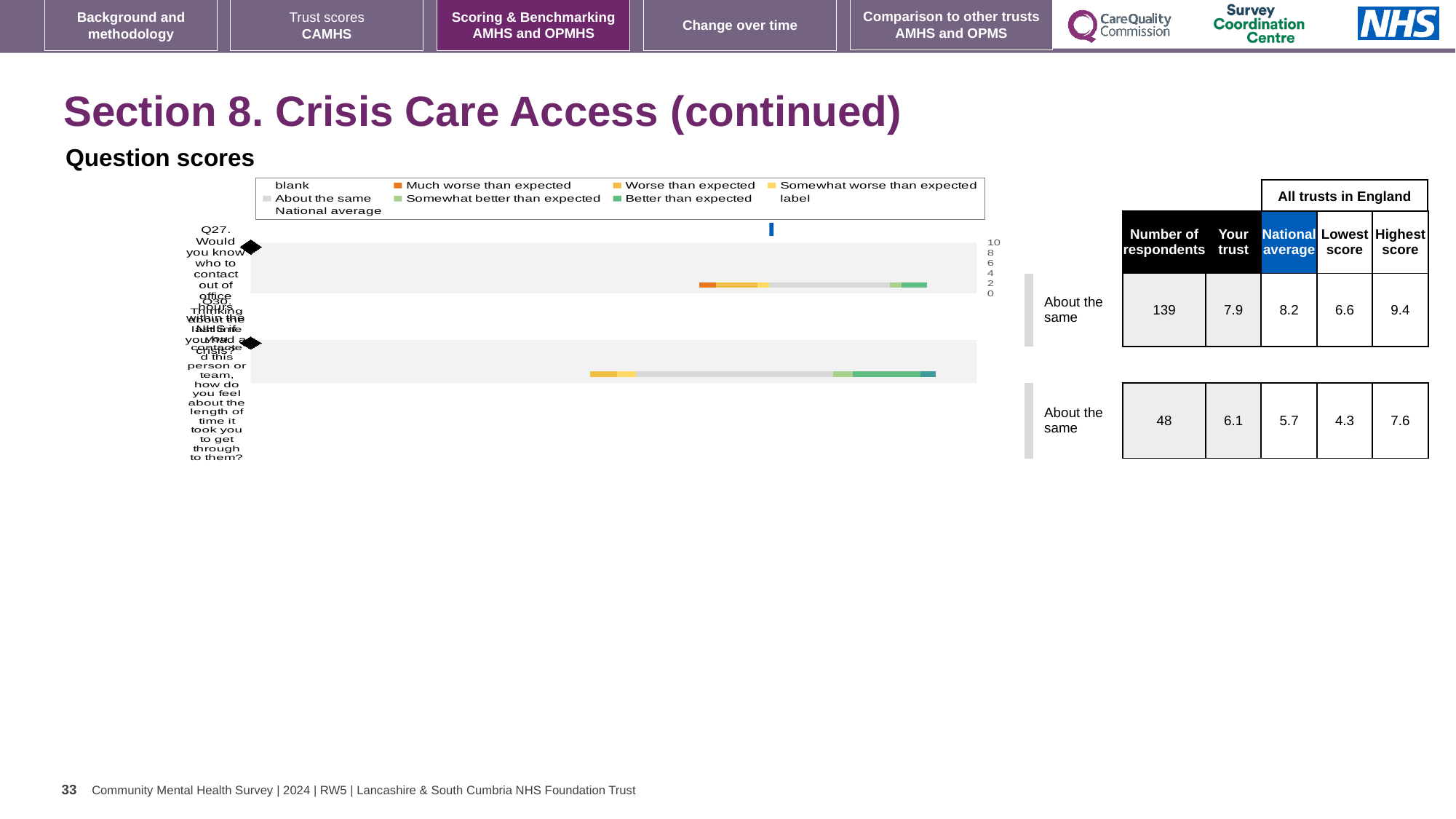
What is the 'Your trust' score for Q27 (Would you know who to contact out of office hours)? 7.9 How many questions (bars) are plotted in the chart? 2 What is the national average score for Q27? 8.2 For Q27, which is larger: the 'Your trust' score or the national average? National average How many respondents answered Q30? 48 For Q30, which is larger: the 'Your trust' score or the national average? Your trust What is the highest score among all trusts in England for Q30? 7.6 What is the lowest score among all trusts in England for Q27? 6.6 What kind of chart is shown under 'Question scores'? bar chart What is the maximum value shown on the chart's score axis? 10 What is the difference between the highest and lowest scores for Q27? 2.8 What benchmark category is given for Q30? About the same